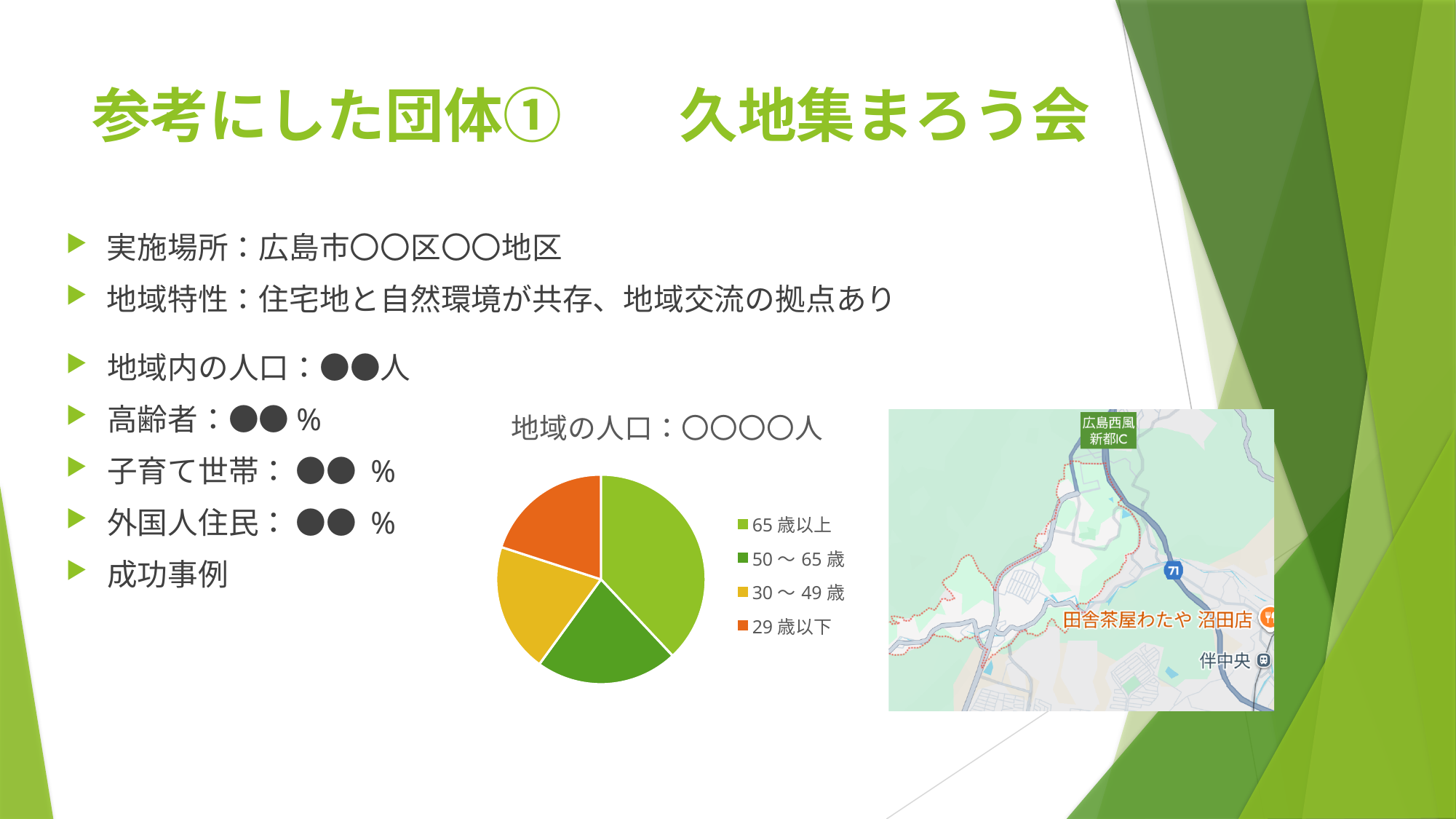
What is the title of the pie chart? 地域の人口：〇〇〇〇人 What kind of chart is shown on the slide? pie chart Which slice is larger in the pie chart, 65 歳以上 or 29 歳以下? 65 歳以上 Which category is shown in orange in the pie chart? 29 歳以下 How many slices does the pie chart have? 4 Which slice is larger in the pie chart, 65 歳以上 or 50 ～ 65 歳? 65 歳以上 Which category has the largest slice in the pie chart? 65 歳以上 Which slice is larger in the pie chart, 65 歳以上 or 30 ～ 49 歳? 65 歳以上